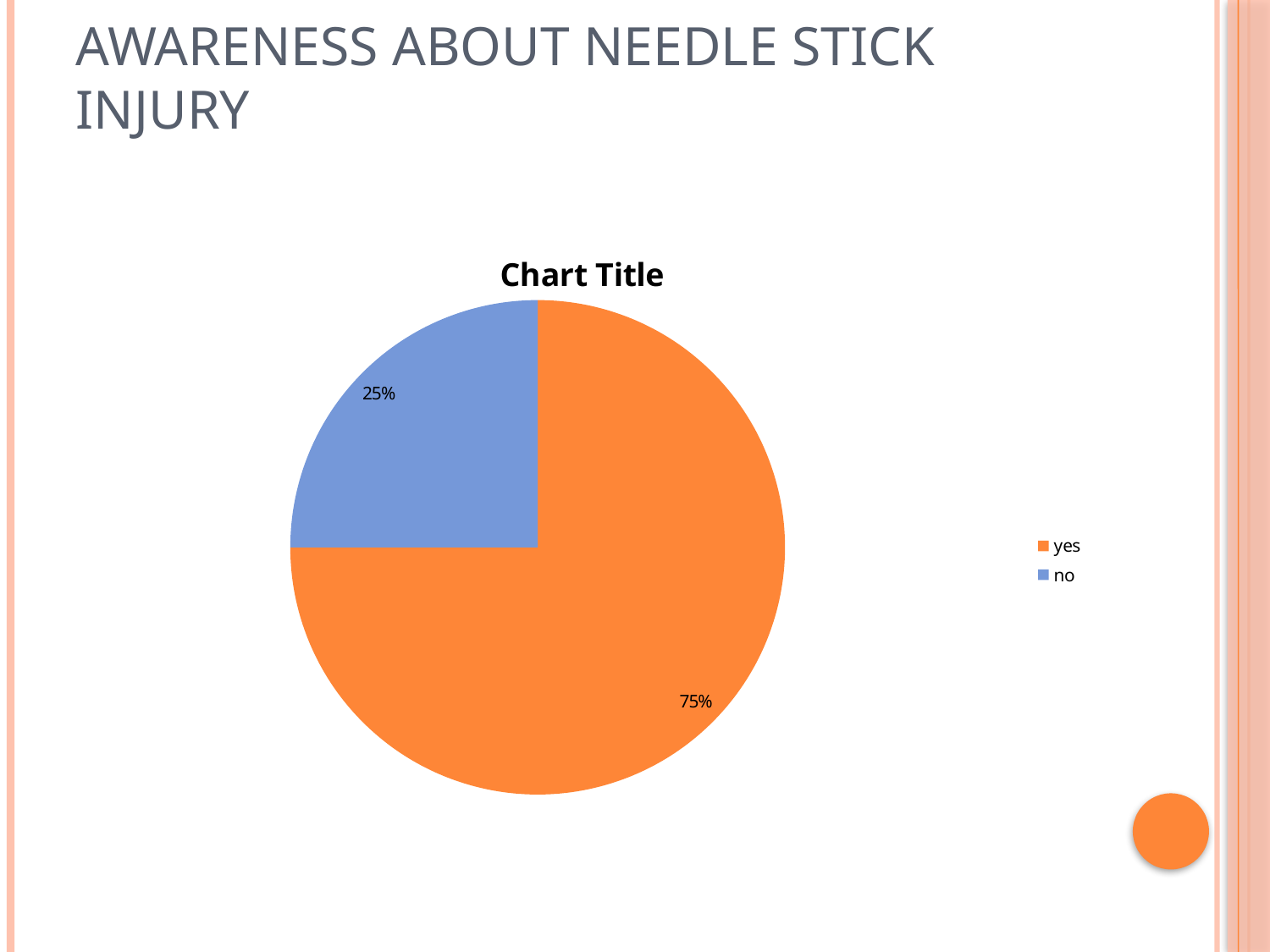
Which category has the smallest share of the pie? no How many entries does the legend list? 2 How many slices does the pie chart have? 2 What type of chart is shown on the slide? pie chart Which category has the largest share of the pie? yes What colour is the "no" slice of the pie? blue What percentage of the pie is labelled "yes"? 75% What share of the pie does the "yes" slice represent? 75% Which slice is larger, "yes" or "no"? yes What is the title shown above the pie chart? Chart Title What is the difference in percentage points between the "yes" and "no" slices? 50 What percentage of the pie is labelled "no"? 25%